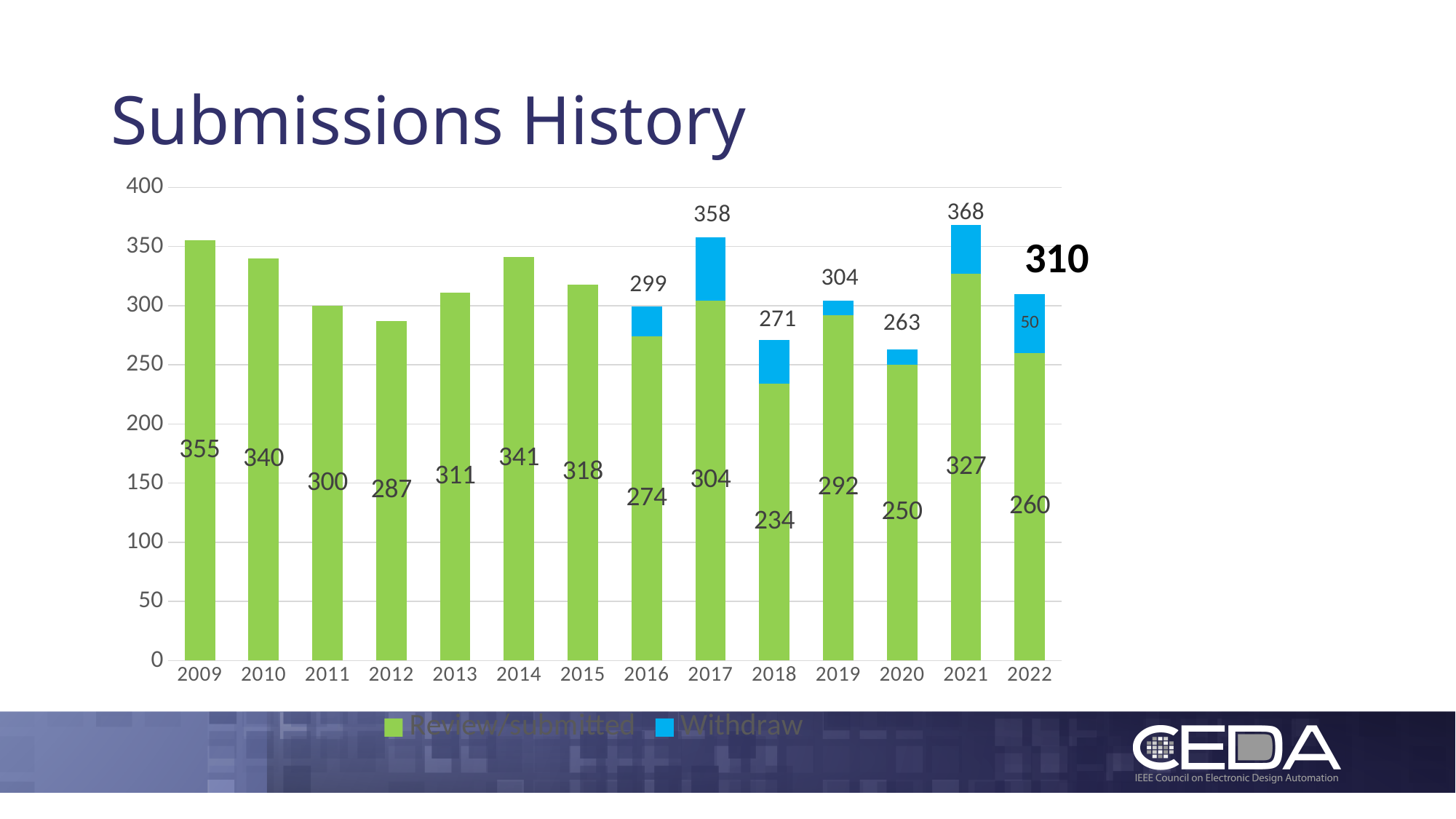
How many series does the legend list? 2 What is the difference between the Review/submitted values for 2009 and 2012? 68 What is the total of the stacked bar for 2022? 310 What is the Review/submitted value for 2009? 355 How many years are shown on the x axis? 14 What is the Withdraw value for 2022? 50 Which is larger, the Review/submitted value for 2014 or for 2015? 2014 What kind of chart is shown on the slide? Stacked bar chart Which year has the lowest Review/submitted value? 2018 What is the Review/submitted value for 2018? 234 What is the total of the stacked bar for 2021? 368 Which year has the highest Review/submitted value? 2009